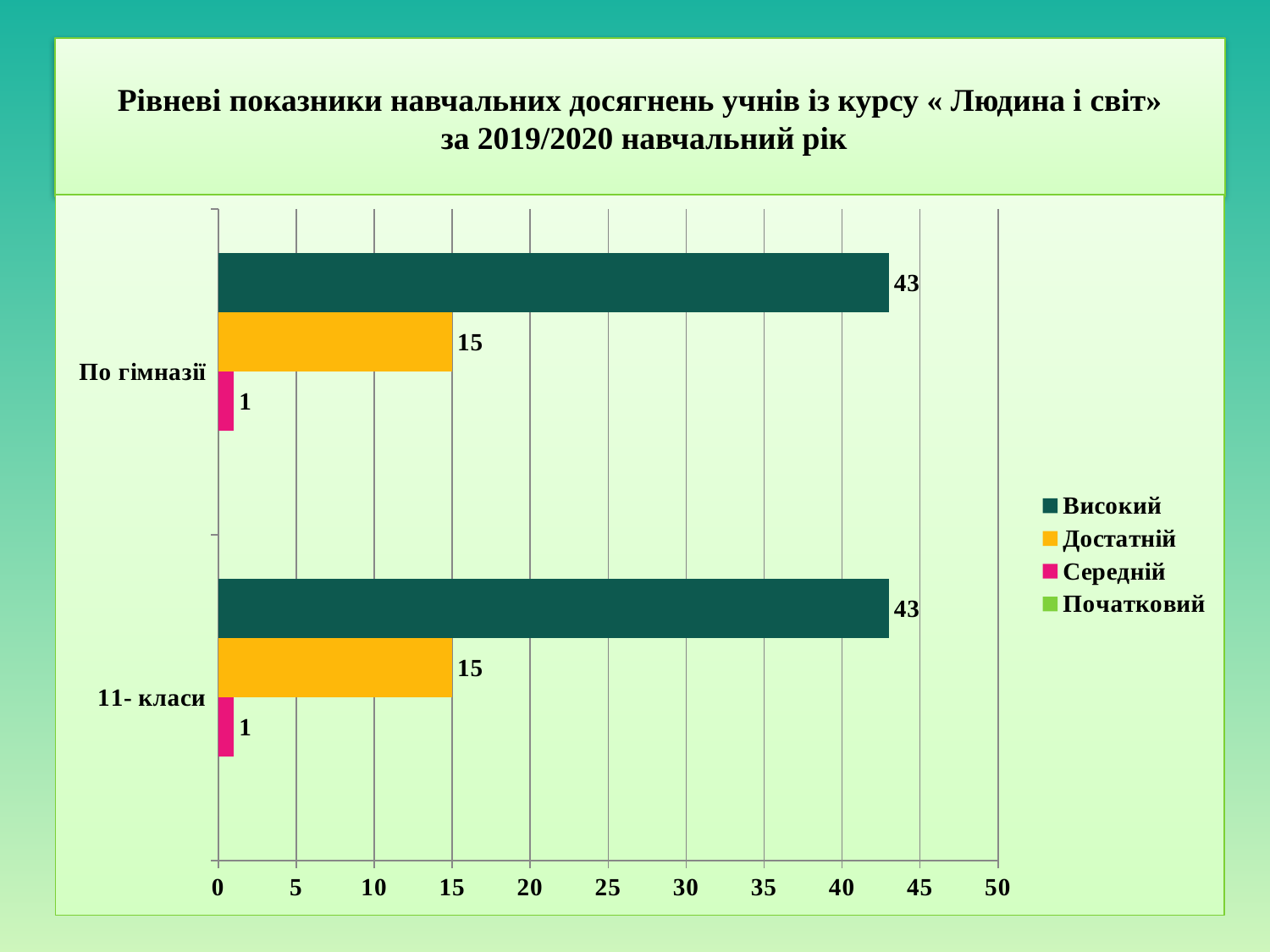
Which series has the highest value in the По гімназії category? Високий Is the value for Високий in the По гімназії category greater or less than 40? greater How many series does the legend list? 4 What colour is the Достатній series in the legend? orange What is the value for Високий in the 11- класи category? 43 What is the difference between the Високий and Достатній values in the 11- класи category? 28 Which is larger in the По гімназії category: Достатній or Середній? Достатній What kind of chart is shown on the slide? bar chart What is the value for Середній in the 11- класи category? 1 What is the value for Достатній in the По гімназії category? 15 How many categories are shown on the vertical axis? 2 Which series with a visible bar has the lowest value in the 11- класи category? Середній